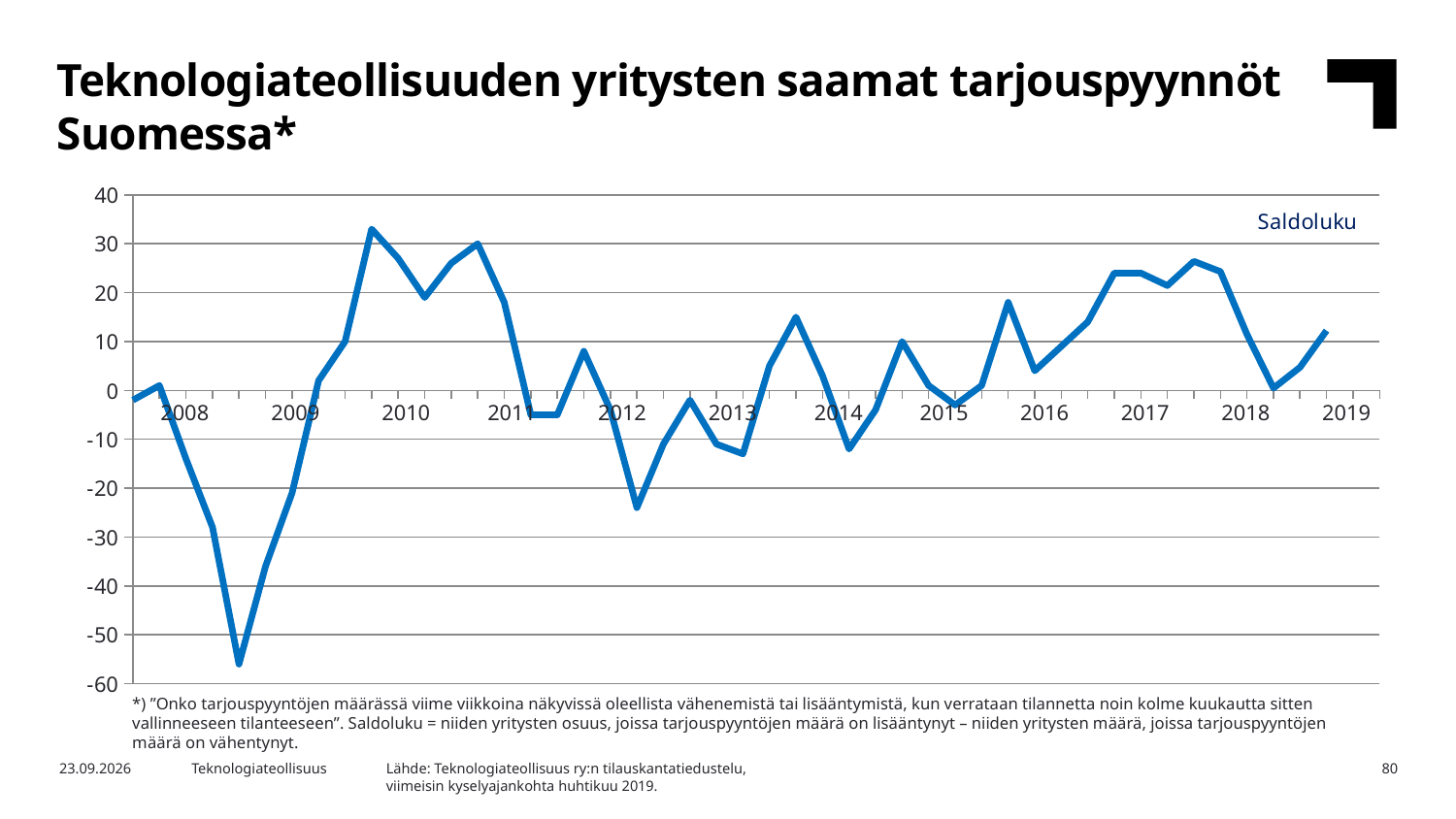
Is the value at the start of 2019 greater or less than 0? greater Which is higher: the peak of the line around 2010 or the peak around 2017? the peak around 2010 How many year labels are shown on the x axis? 12 Is the low point of the line in 2012 greater or less than -20? less Is the lowest value of the line greater or less than -50? less Does the line rise or fall between early 2009 and 2010? rise What is the title of the chart on the slide? Teknologiateollisuuden yritysten saamat tarjouspyynnöt Suomessa* Does the line rise or fall between 2008 and early 2009? fall What kind of chart is shown on the slide? line chart What series label is shown in the chart's legend? Saldoluku In which year does the line reach its lowest value? 2009